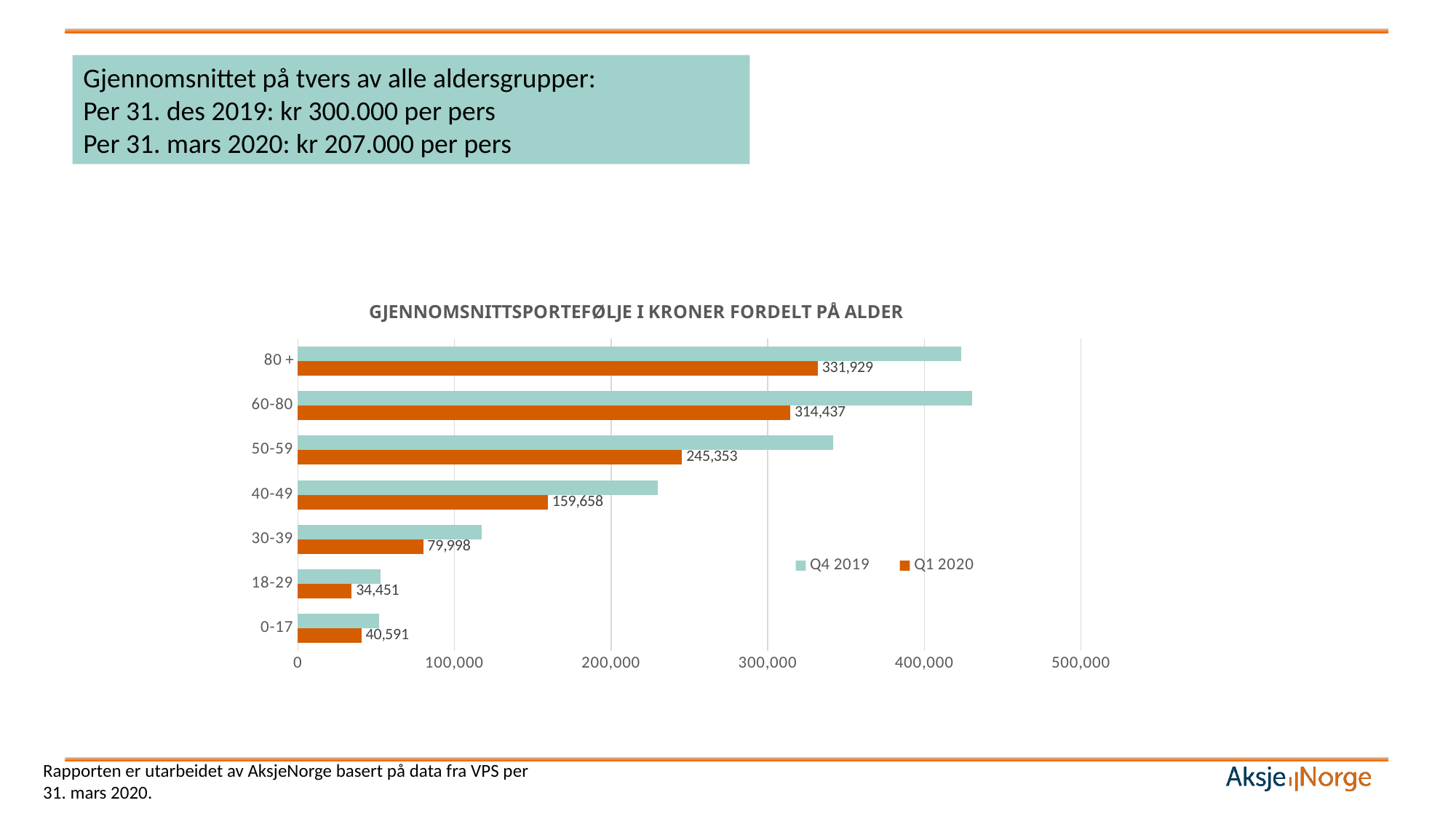
What is the difference between the Q1 2020 values for 50-59 and 40-49? 85,695 How many age groups are shown on the chart? 7 How many series does the chart's legend list? 2 Is the Q4 2019 value for the 80 + age group greater or less than 400,000? greater Which age group has the lowest Q1 2020 value? 18-29 Which has the larger Q1 2020 value, 0-17 or 18-29? 0-17 Which age group has the highest Q1 2020 value? 80 + What is the Q1 2020 value for the 30-39 age group? 79,998 What is the Q1 2020 value for the 80 + age group? 331,929 What is the title of the chart? GJENNOMSNITTSPORTEFØLJE I KRONER FORDELT PÅ ALDER What type of chart is shown on the slide? Bar chart Is the Q4 2019 value for the 18-29 age group greater or less than 100,000? less